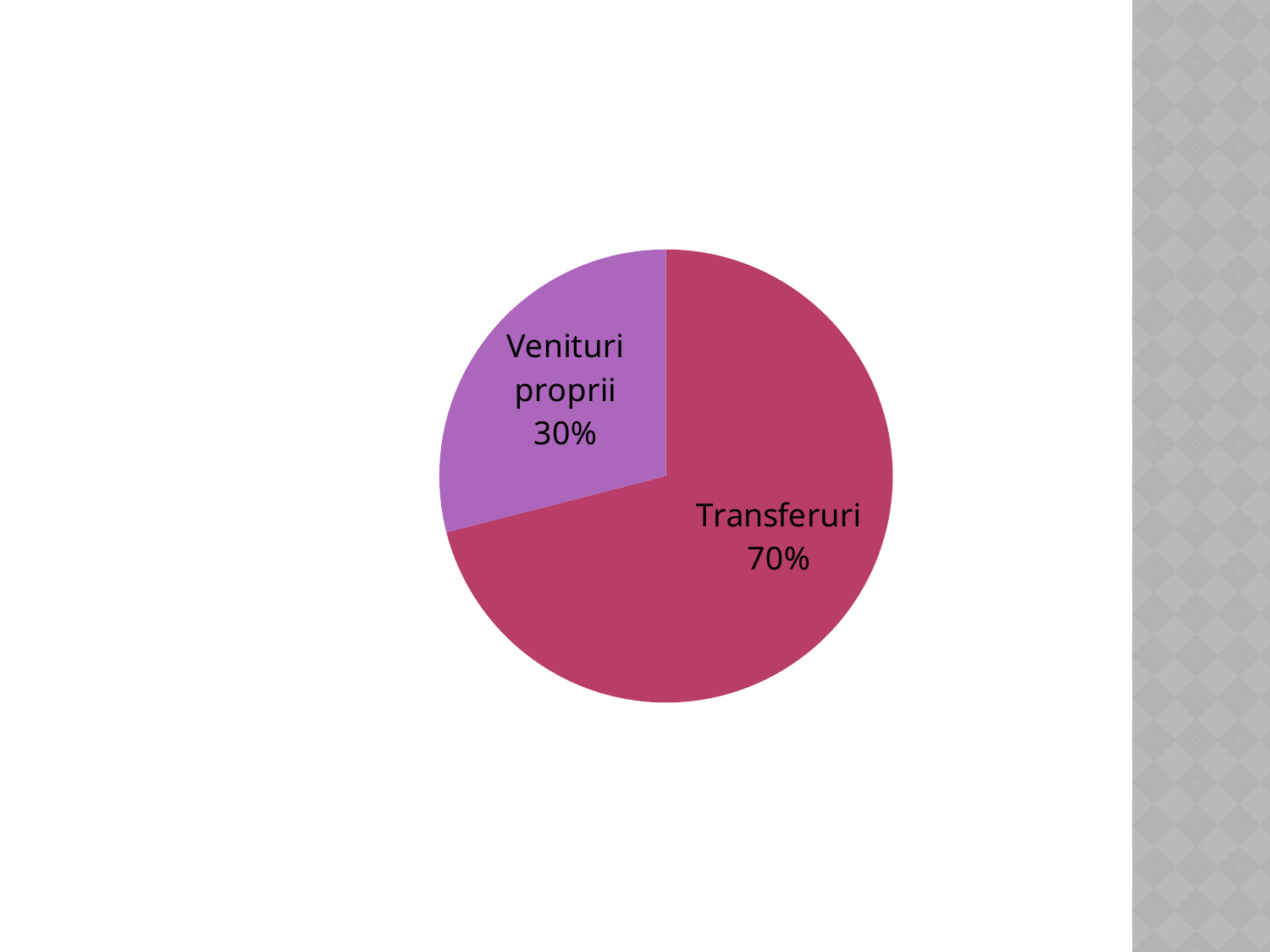
What share of the pie does Venituri proprii represent? 30% Which slice of the pie is the largest? Transferuri What kind of chart is shown on the slide? pie chart What is the difference in percentage points between Transferuri and Venituri proprii? 40% What colour is the Transferuri slice? magenta Is the share for Venituri proprii greater or less than 50%? less Which is larger, Transferuri or Venituri proprii? Transferuri Which slice of the pie is the smallest? Venituri proprii What share of the pie does Transferuri represent? 70% How many slices does the pie chart have? 2 What colour is the Venituri proprii slice? purple